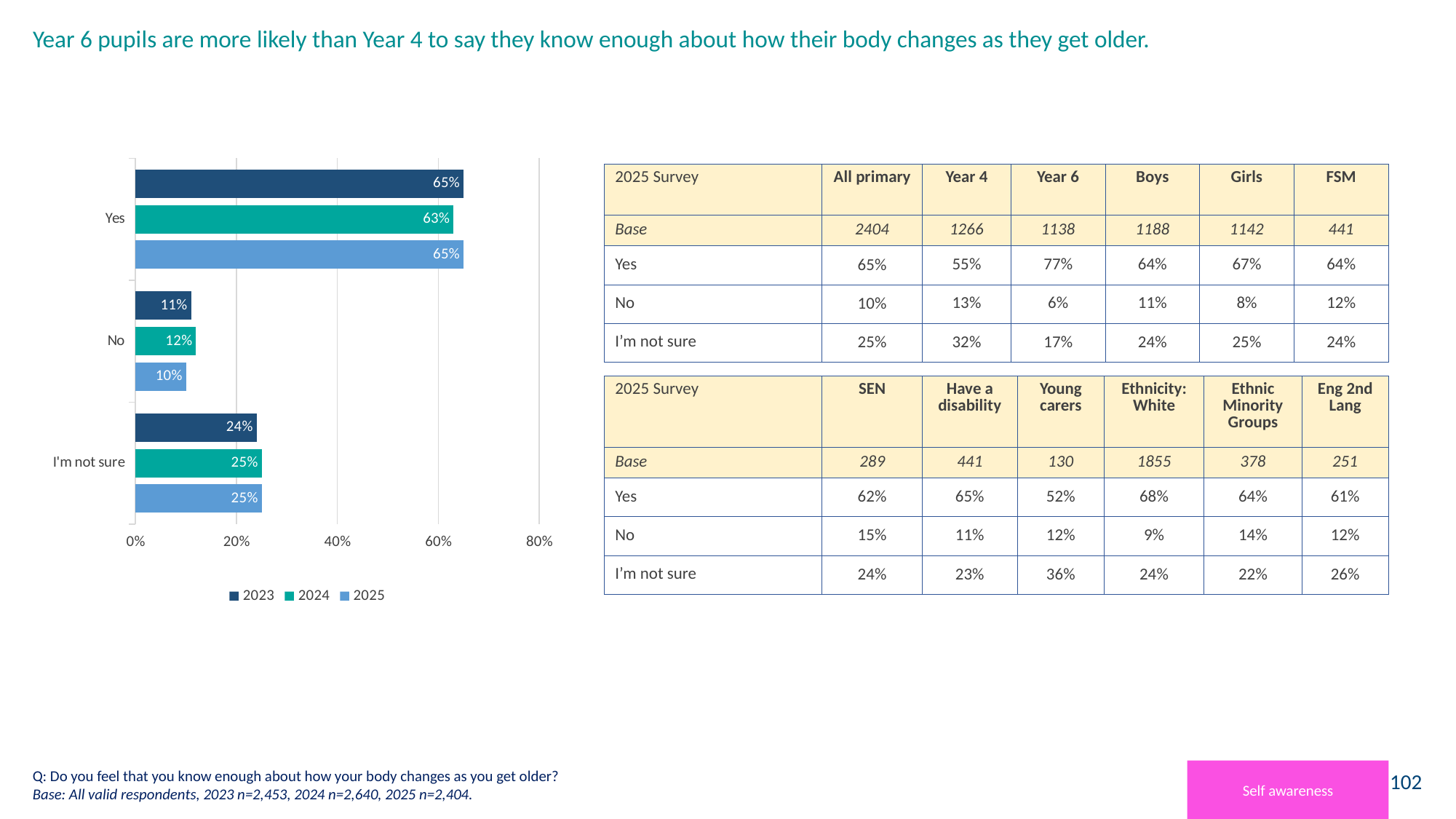
What is the value for 'I'm not sure' in 2023 in the bar chart? 24% In the bar chart, is the 'No' value for 2023 larger or smaller than the 'No' value for 2024? smaller Which response category has the highest value for 2025 in the bar chart? Yes What is the highest value shown on the x axis of the bar chart? 80% How many response categories are shown on the bar chart? 3 How many series does the legend of the bar chart list? 3 What percentage of pupils answered 'Yes' in 2024 according to the bar chart? 63% What is the value for 'No' in 2025 in the bar chart? 10% What type of chart is shown on the left of the slide? Bar chart Which response category has the lowest value for 2023 in the bar chart? No Which years are listed in the legend of the bar chart? 2023, 2024, 2025 What is the difference between the 'Yes' value and the 'I'm not sure' value for 2025 in the bar chart? 40 percentage points